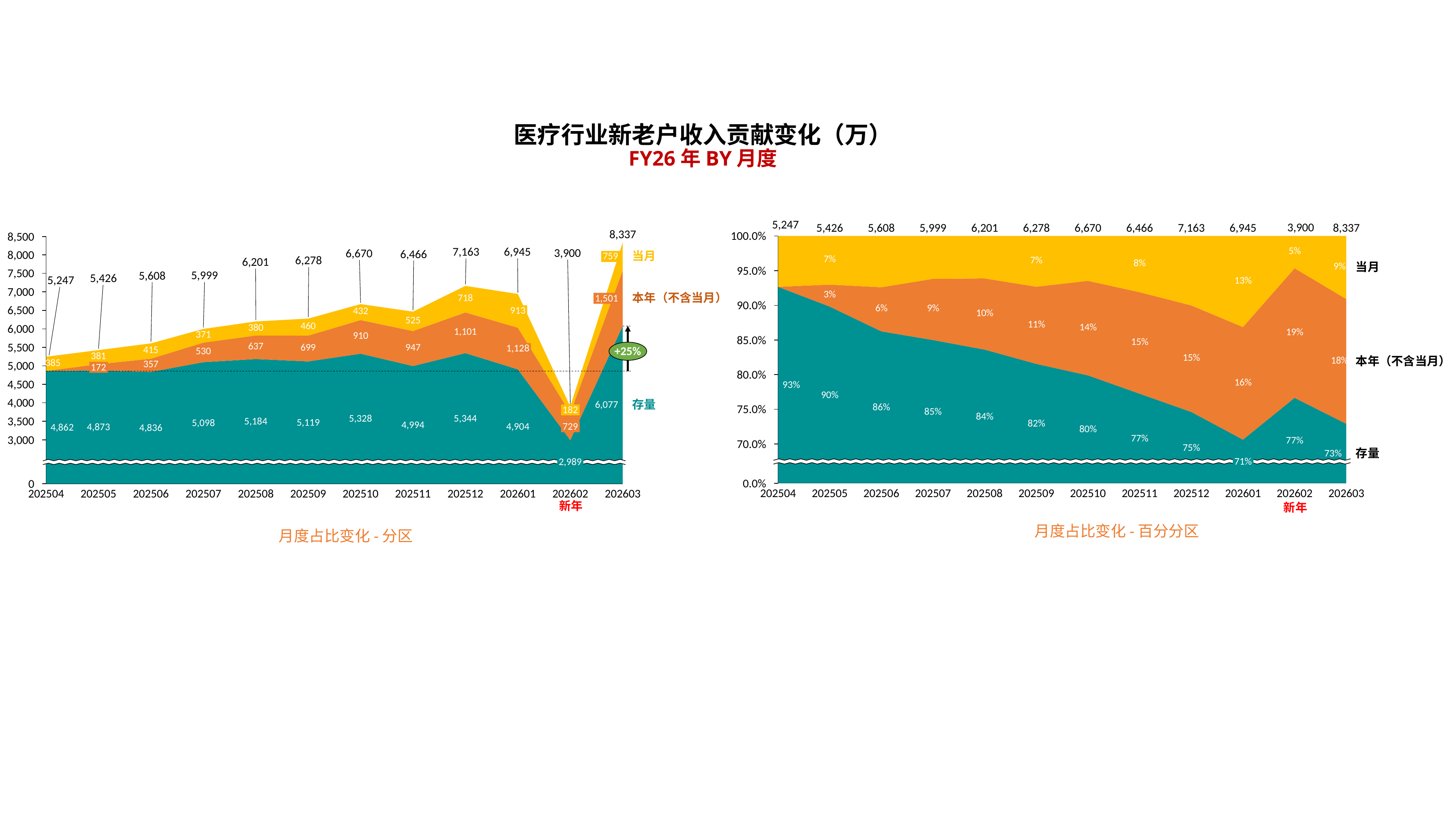
On the left chart (月度占比变化 - 分区), which is larger, the 存量 value for 202510 or for 202511? 202510 On the left chart (月度占比变化 - 分区), how many series are stacked in the chart? 3 On the right chart (月度占比变化 - 百分分区), what is the 存量 share for 202504? 93% On the left chart (月度占比变化 - 分区), what is the total value shown for 202603? 8,337 What kind of chart is the left chart (月度占比变化 - 分区)? Stacked area chart On the left chart (月度占比变化 - 分区), what is the 存量 value for 202602? 2,989 On the left chart (月度占比变化 - 分区), what is the difference between the total for 202603 and the total for 202602? 4,437 On the left chart (月度占比变化 - 分区), how many months are plotted on the x axis? 12 On the left chart (月度占比变化 - 分区), what is the 当月 value for 202601? 913 On the left chart (月度占比变化 - 分区), which month has the highest total value? 202603 On the left chart (月度占比变化 - 分区), which month has the lowest total value? 202602 On the right chart (月度占比变化 - 百分分区), what is the 本年（不含当月） share for 202603? 18%